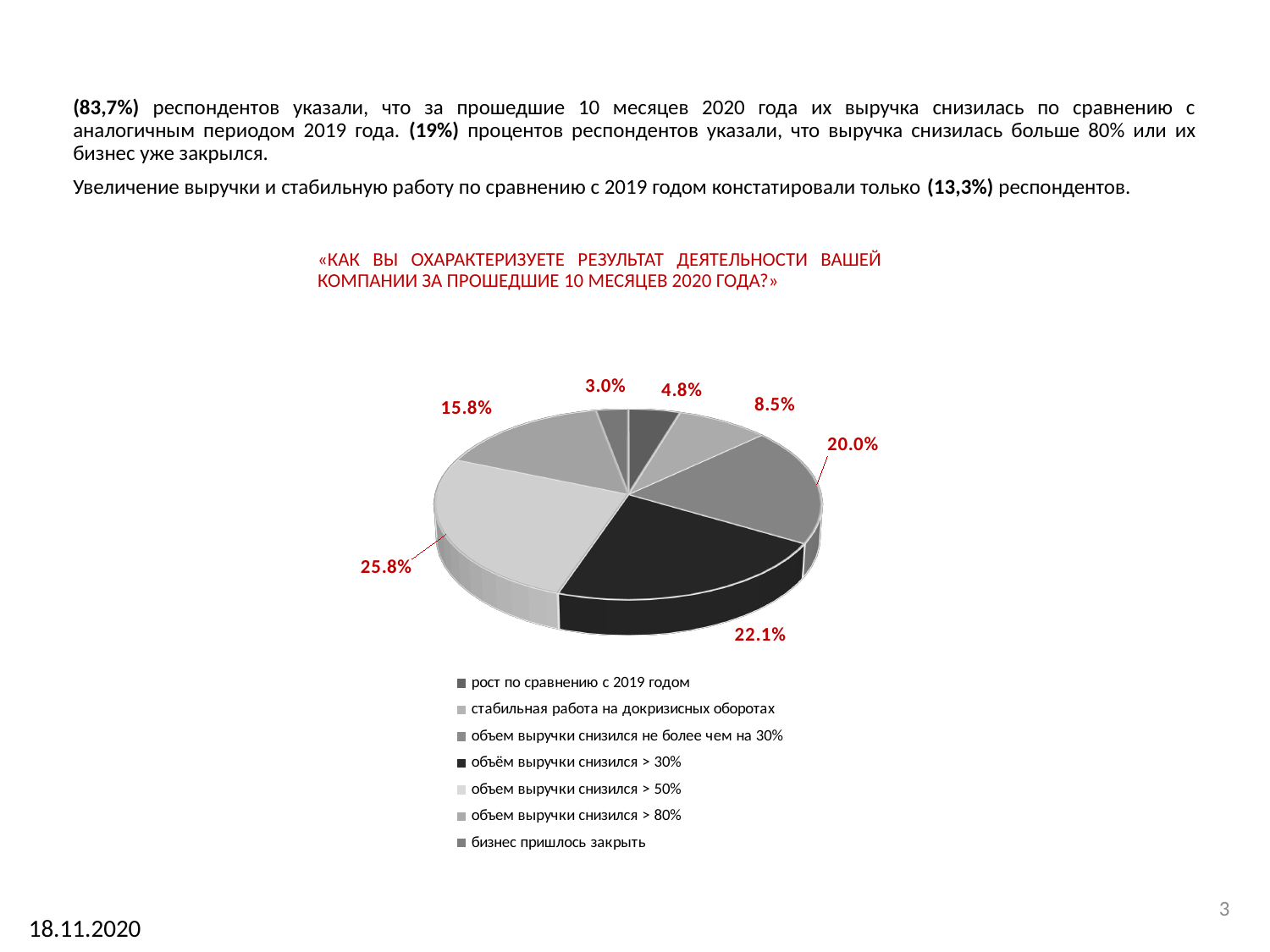
How many slices does the pie chart have? 7 What share of respondents reported that revenue decreased by more than 30% (объём выручки снизился > 30%)? 22.1% How many entries does the chart legend list? 7 What kind of chart is shown on the slide? pie chart What is the combined share of the slices labelled 4.8% and 8.5%? 13.3% What is the largest share shown on the pie chart? 25.8% What share of respondents had to close their business (бизнес пришлось закрыть)? 3.0% What share of respondents reported that revenue decreased by more than 50% (объем выручки снизился > 50%)? 25.8% What share of respondents reported growth compared to 2019 (рост по сравнению с 2019 годом)? 4.8% What is the smallest share shown on the pie chart? 3.0% Which is larger: the slice labelled 20.0% or the slice labelled 15.8%? 20.0% What is the difference between the largest slice (25.8%) and the second largest slice (22.1%)? 3.7%